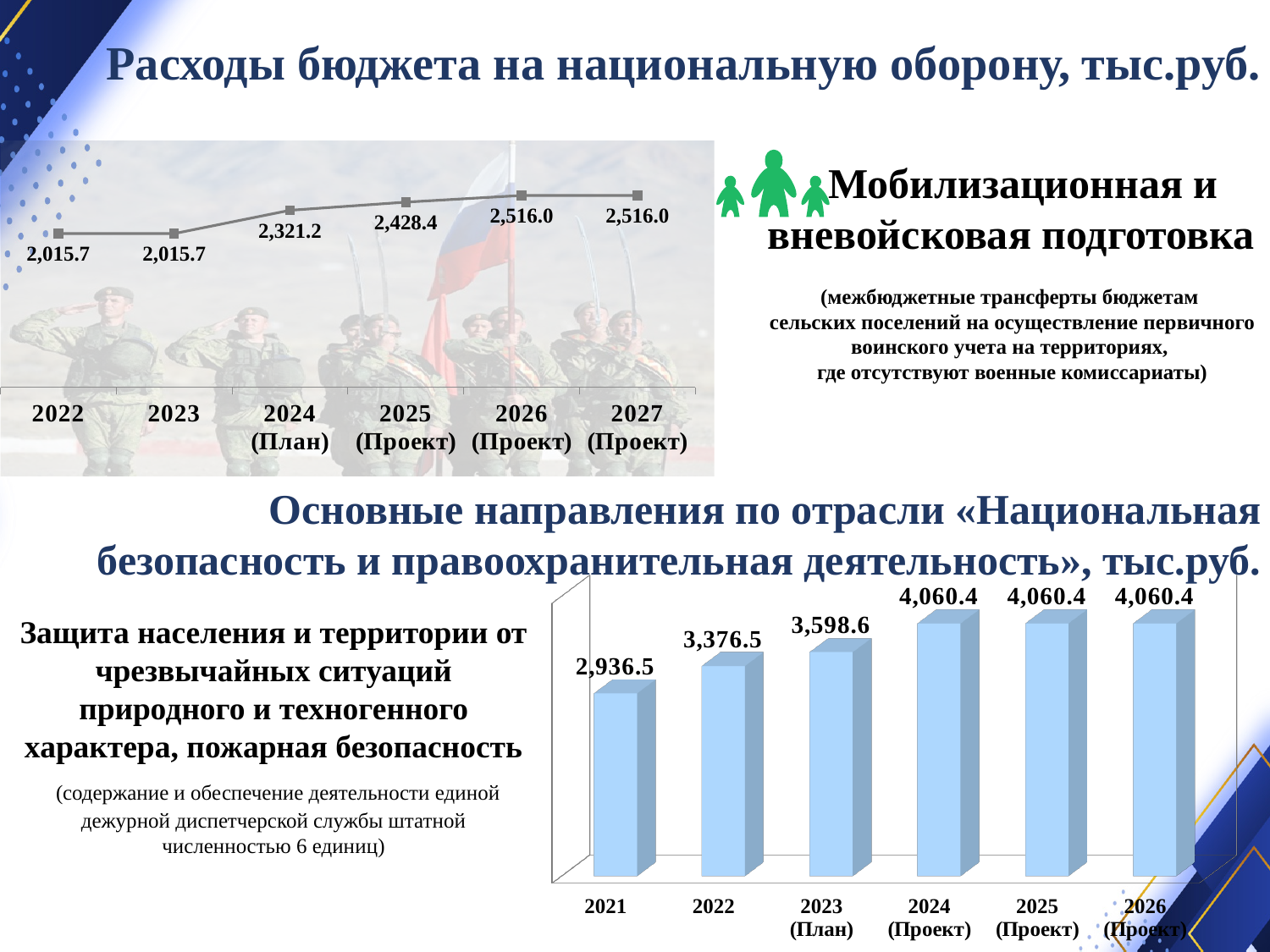
In the bottom bar chart, which year has the lowest value? 2021 In the top line chart, what is the value for 2025 (Проект)? 2,428.4 In the top line chart, do the values rise or fall from 2022 to 2027? rise What kind of chart is the bottom chart on the slide? bar chart In the top line chart, what is the value for 2022? 2,015.7 What kind of chart is the top chart on the slide? line chart In the top line chart, what is the difference between the values for 2025 (Проект) and 2024 (План)? 107.2 In the bottom bar chart (Основные направления по отрасли «Национальная безопасность и правоохранительная деятельность»), what is the value for 2021? 2,936.5 In the bottom bar chart, what is the value for 2023 (План)? 3,598.6 In the top line chart (Расходы бюджета на национальную оборону), what is the value for 2024 (План)? 2,321.2 How many data points are plotted in the top line chart? 6 In the bottom bar chart, what is the difference between the values for 2022 and 2021? 440.0